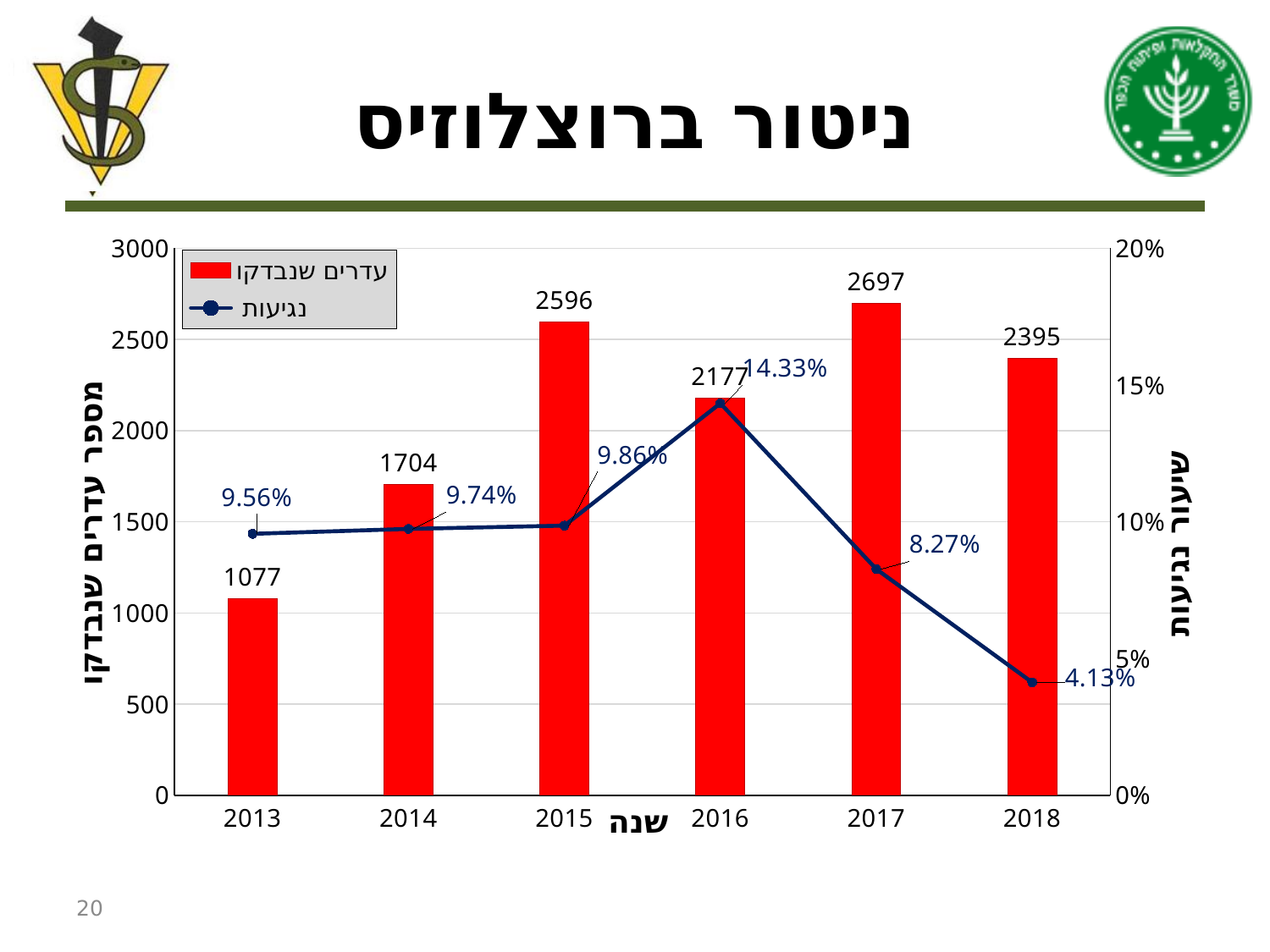
How many herds were tested (עדרים שנבדקו) in 2015? 2596 Which year had more herds tested, 2016 or 2018? 2018 In which year was the number of herds tested the highest? 2017 What was the infection rate (נגיעות) in 2018? 4.13% Did the infection rate (נגיעות) rise or fall from 2016 to 2018? fall What is the difference in the number of herds tested between 2017 and 2013? 1620 In which year was the number of herds tested the lowest? 2013 In which year was the infection rate (נגיעות) the lowest? 2018 How many series does the legend list? 2 What is the title of the slide? ניטור ברוצלוזיס What was the infection rate (נגיעות) in 2016? 14.33% How many years are shown on the x axis? 6